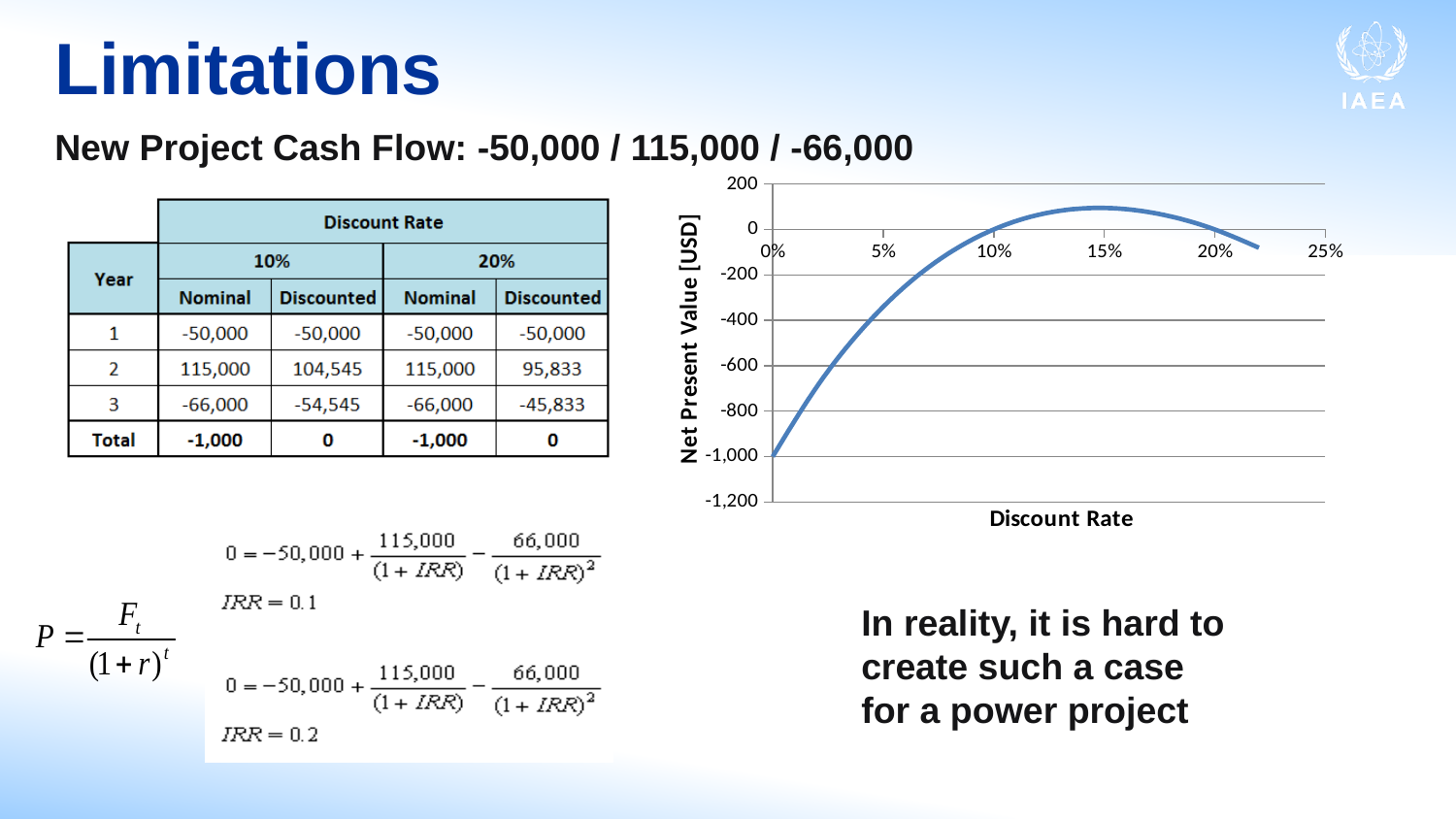
At which labelled discount rate on the x axis is the net present value highest? 15% Is the net present value at a discount rate of 15% greater or less than 0? greater What is the net present value at a discount rate of 0%? -1,000 What kind of chart is shown on the slide? line chart At which labelled discount rate on the x axis is the net present value lowest? 0% Which is larger, the net present value at 5% or at 20%? 20% Is the net present value at a discount rate of 5% greater or less than -200? less Between discount rates of 0% and 10%, does the net present value rise or fall? rise What is the title of the x axis of the chart? Discount Rate What is the title of the y axis of the chart? Net Present Value [USD] What is the net present value at a discount rate of 20%? 0 What is the net present value at a discount rate of 10%? 0